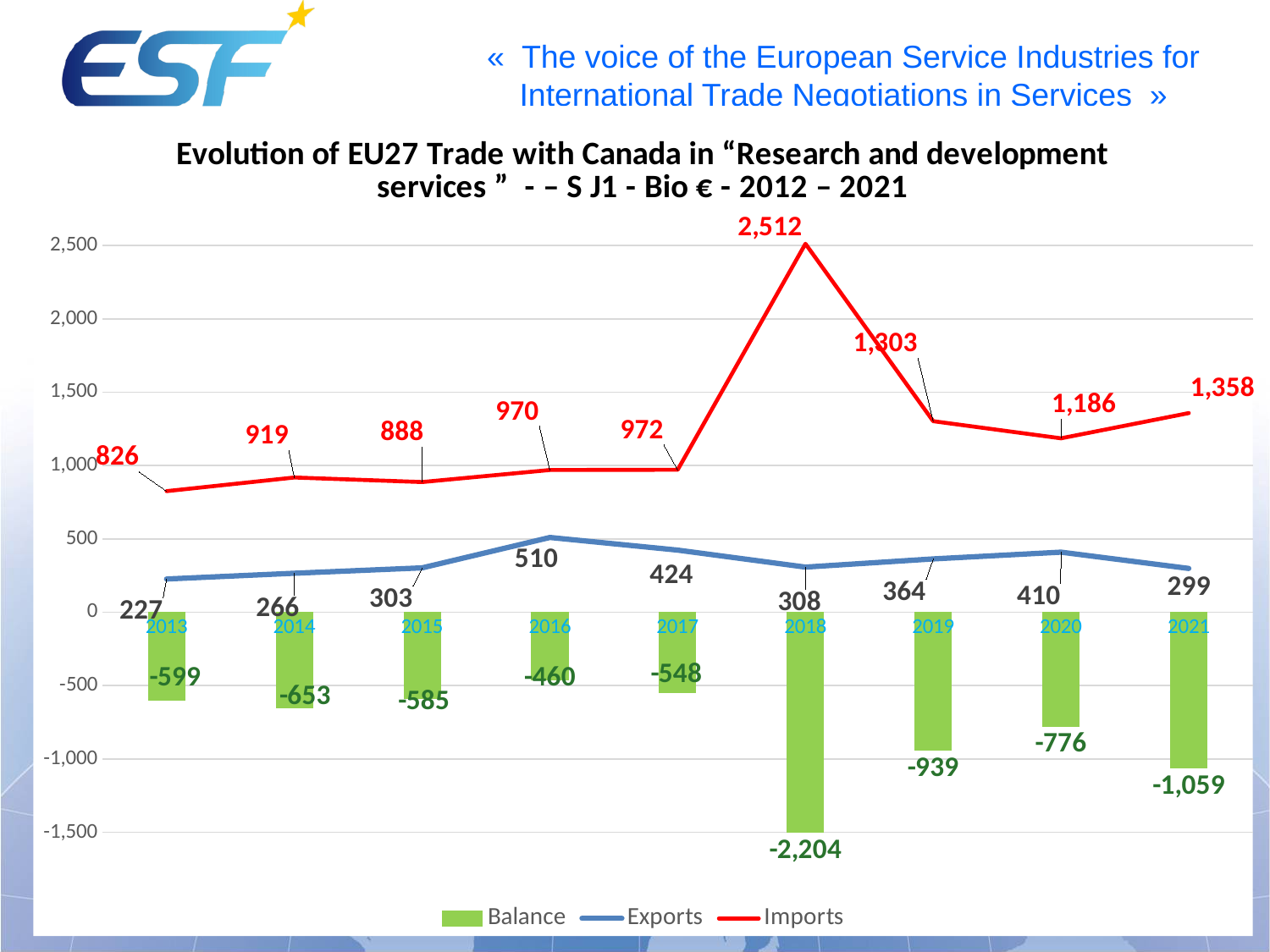
What kind of chart is this? Combination bar and line chart How many series does the legend list? 3 What is the value of Imports in 2018? 2,512 What is the difference between Imports in 2021 and Imports in 2020? 172 Which year has the most negative Balance? 2018 What is the value of Exports in 2016? 510 What is the Balance value for 2021? -1,059 Which is larger, Exports in 2017 or Exports in 2019? 2017 How many years are shown on the x axis? 9 In which year are Exports lowest? 2013 Between 2018 and 2020, do Imports rise or fall? Fall In which year are Imports highest? 2018